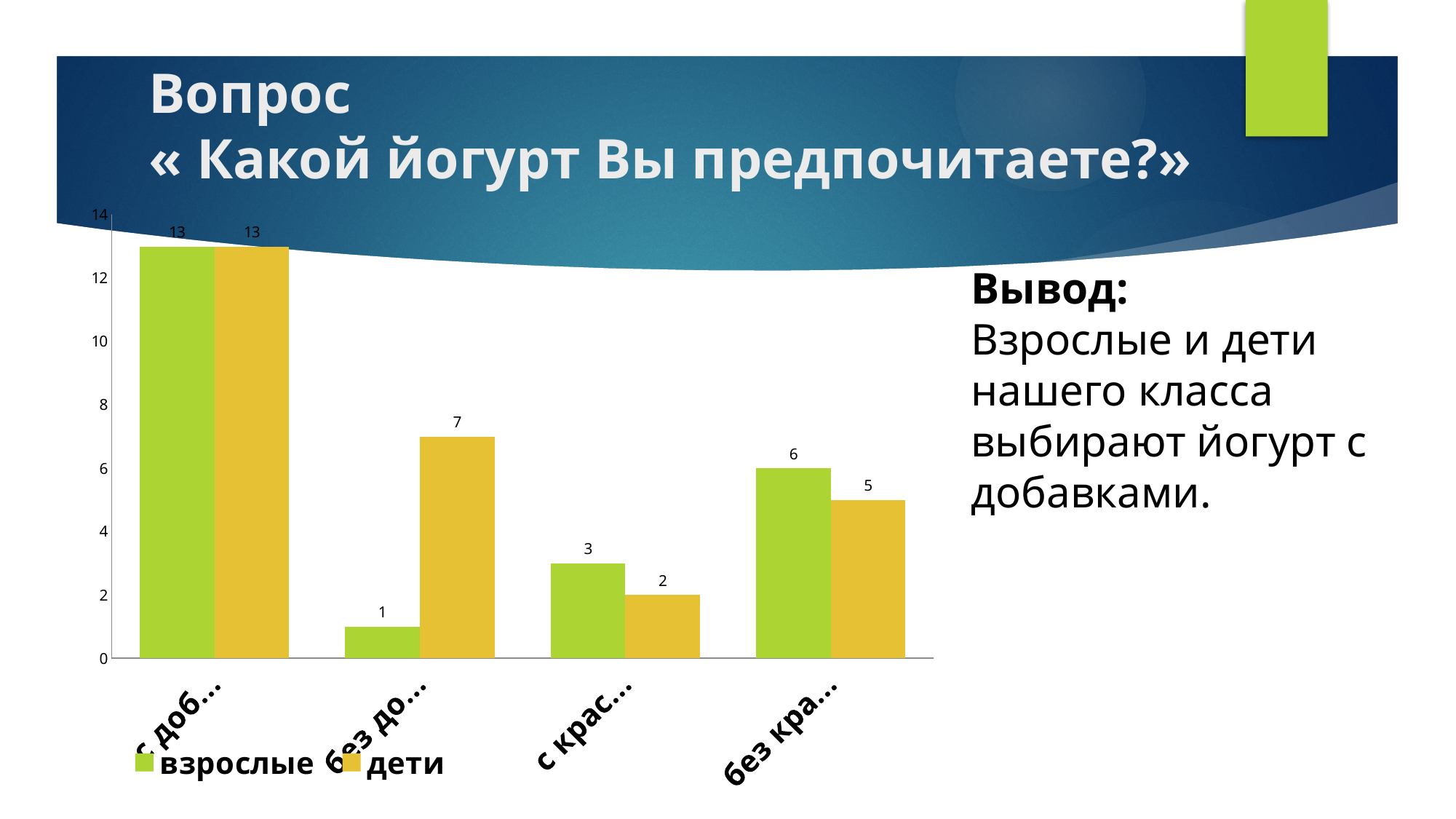
What is the difference between the дети and взрослые values in the second category ("без до…")? 6 Which category has the highest value for дети? с доб… Which category has the lowest value for взрослые? без до… What is the value for взрослые in the third category ("с крас…")? 3 In the fourth category ("без кра…"), which series has the larger value, взрослые or дети? взрослые How many series does the chart legend list? 2 What kind of chart is shown on the slide? bar chart What is the value for дети in the fourth category ("без кра…")? 5 What is the value for дети in the second category ("без до…")? 7 What is the value for взрослые in the first category ("с доб…")? 13 How many categories are shown on the x axis of the chart? 4 Which series is shown in green in the chart? взрослые